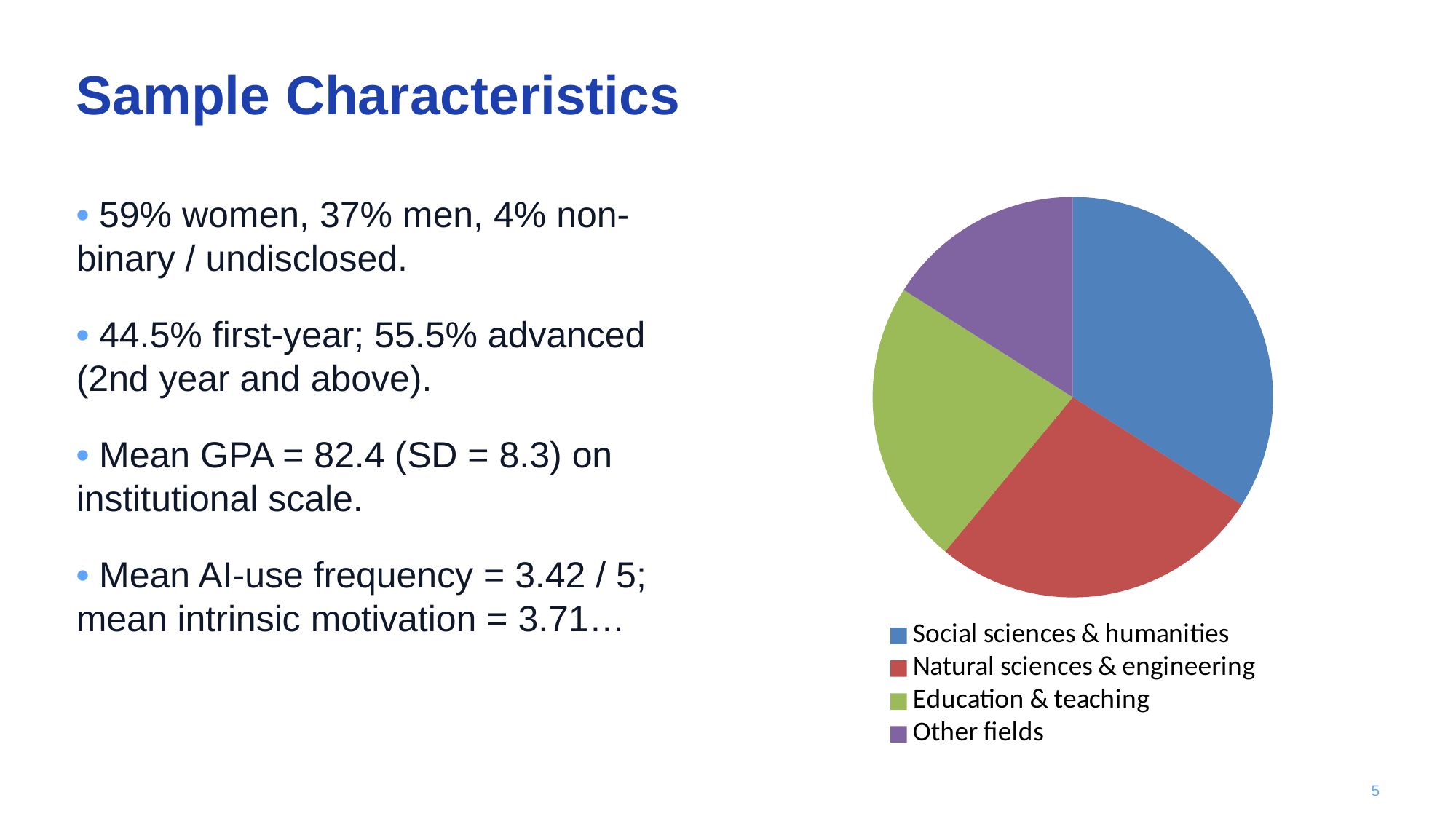
What colour is the Education & teaching slice in the pie chart? Green Which slice is larger: Natural sciences & engineering or Other fields? Natural sciences & engineering Which field is shown in purple in the pie chart? Other fields Which field has the largest slice of the pie chart? Social sciences & humanities How many entries does the pie chart's legend list? 4 How many slices does the pie chart have? 4 Which field has the smallest slice of the pie chart? Other fields What kind of chart is shown on the slide? Pie chart Which slice is larger: Social sciences & humanities or Education & teaching? Social sciences & humanities Which slice is larger: Natural sciences & engineering or Education & teaching? Natural sciences & engineering